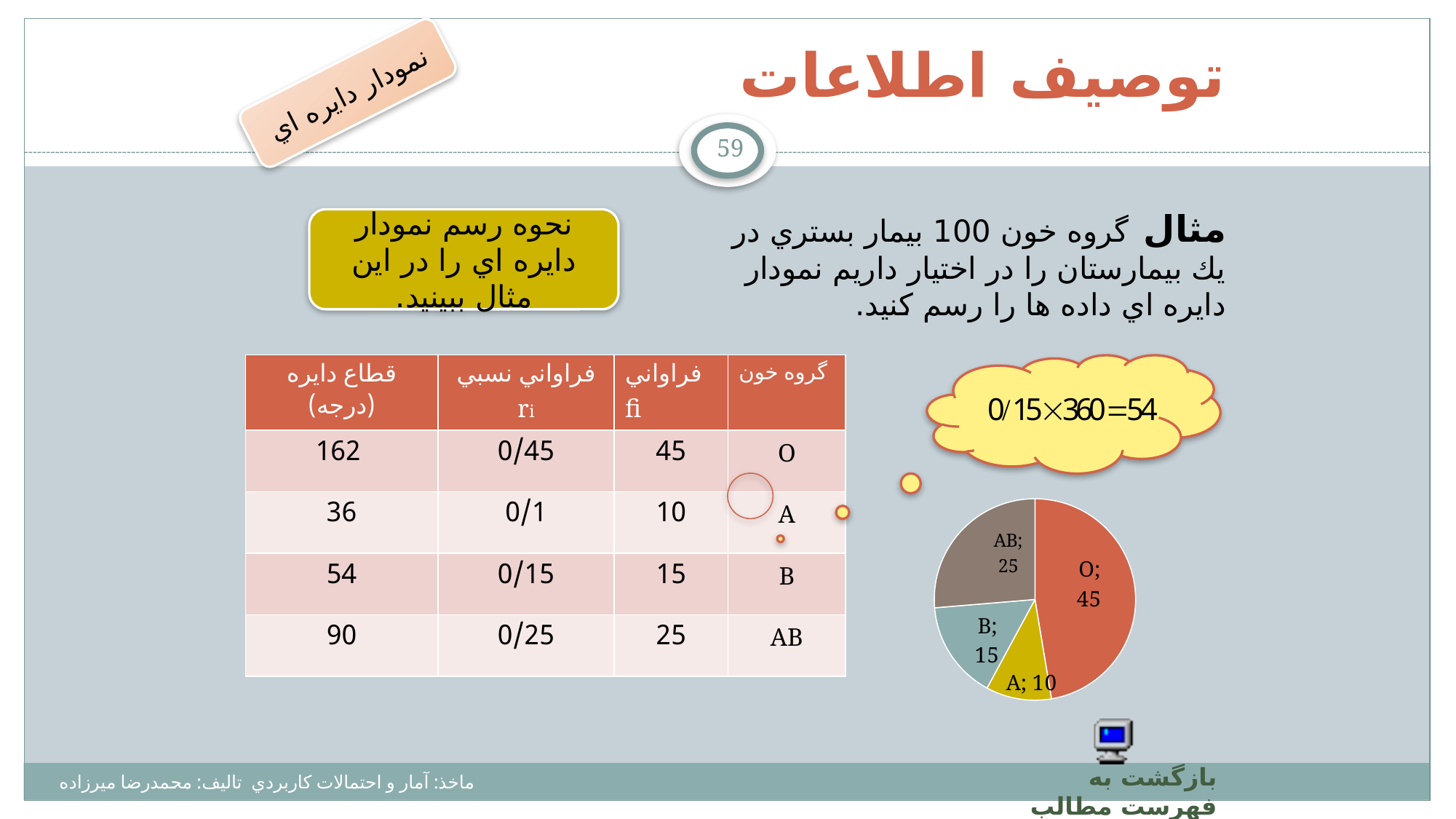
What is the difference between the values for O and AB in the pie chart? 20 What is the value shown for blood group B in the pie chart? 15 How many slices does the pie chart have? 4 What is the total of all the slice values in the pie chart? 100 What kind of chart is shown on the slide? pie chart What is the value shown for blood group AB in the pie chart? 25 Which is larger in the pie chart, the value for B or the value for AB? AB What is the value shown for blood group O in the pie chart? 45 Which blood group has the smallest slice in the pie chart? A What is the value shown for blood group A in the pie chart? 10 What share of the pie does the O slice represent? 45% Which blood group has the largest slice in the pie chart? O